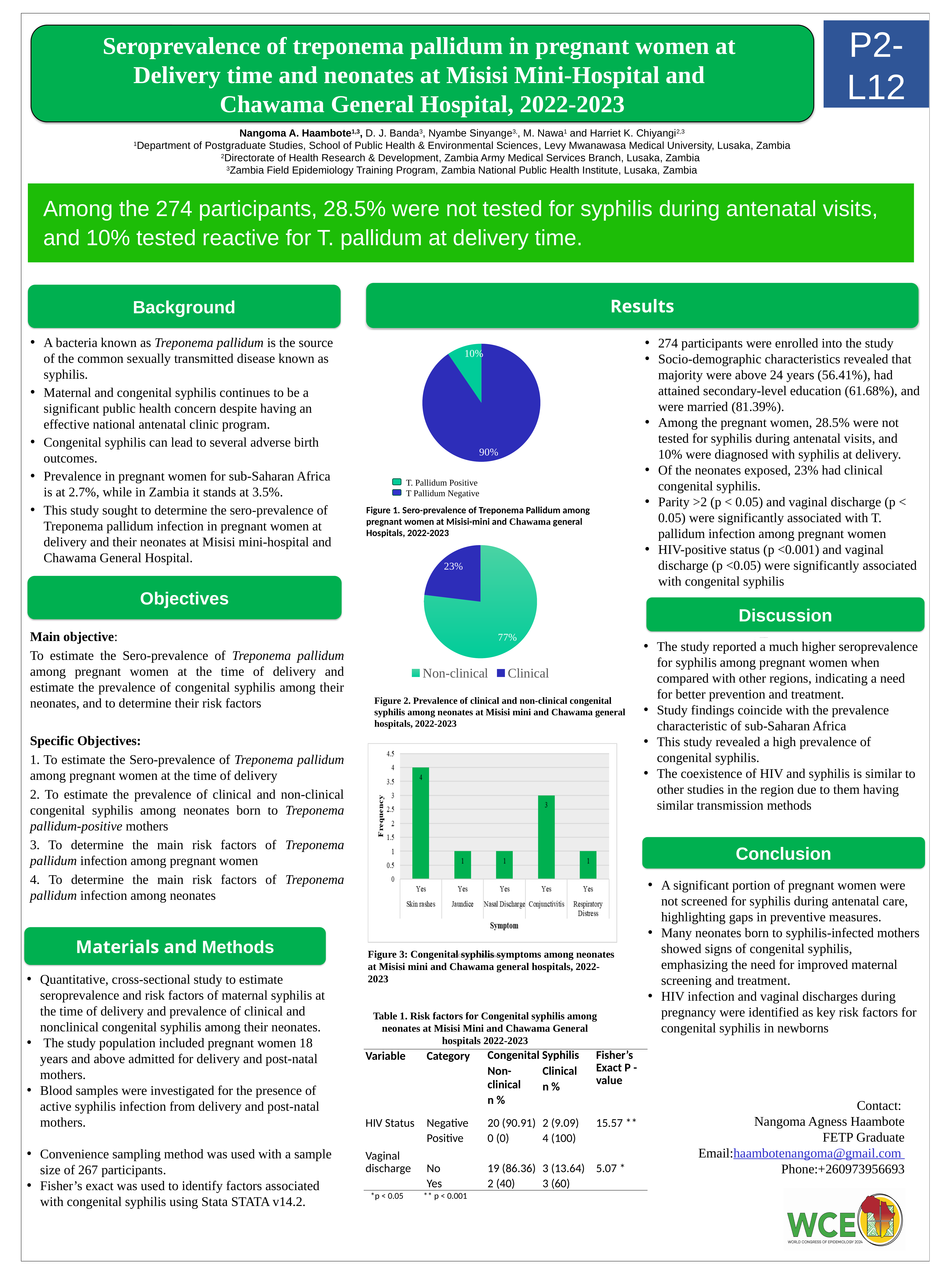
In Figure 3, what is the frequency for Conjunctivitis? 3 In Figure 3, what is the difference in frequency between Skin rashes and Jaundice? 3 In Figure 3, which symptom has the highest frequency? Skin rashes In Figure 2, which slice is larger, Non-clinical or Clinical? Non-clinical What kind of chart is Figure 1? Pie chart In Figure 2, what share of neonates were Non-clinical? 77% In Figure 3, what is the frequency for Skin rashes? 4 In Figure 1, what share of pregnant women were T Pallidum Negative? 90% How many series does the legend of Figure 1 list? 2 In Figure 1, what share of pregnant women were T. Pallidum Positive? 10% How many symptom categories are shown in Figure 3? 5